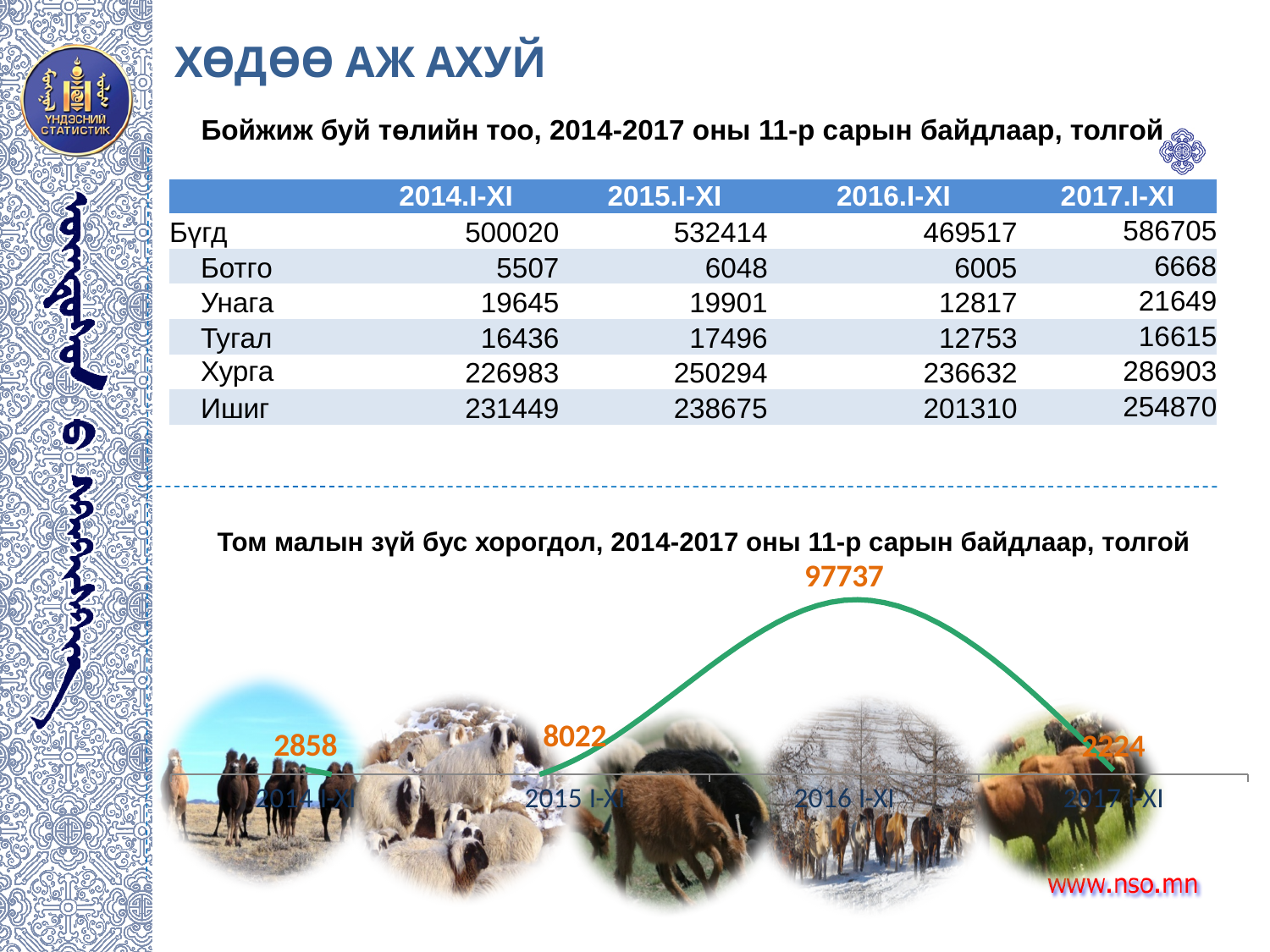
In the chart titled 'Том малын зүй бус хорогдол', what is the value for 2014.I-XI? 2858 In the chart titled 'Том малын зүй бус хорогдол', does the value rise or fall from 2016.I-XI to 2017.I-XI? fall How many data points are plotted in the chart titled 'Том малын зүй бус хорогдол'? 4 In the chart titled 'Том малын зүй бус хорогдол', what is the value for 2015.I-XI? 8022 In the chart titled 'Том малын зүй бус хорогдол, 2014-2017 оны 11-р сарын байдлаар, толгой', what is the value for 2016.I-XI? 97737 In the chart titled 'Том малын зүй бус хорогдол', which is larger, the value for 2015.I-XI or the value for 2014.I-XI? 2015.I-XI In the chart titled 'Том малын зүй бус хорогдол', what is the difference between the values for 2016.I-XI and 2015.I-XI? 89715 In the chart titled 'Том малын зүй бус хорогдол', what is the difference between the values for 2014.I-XI and 2017.I-XI? 634 In the chart titled 'Том малын зүй бус хорогдол', what is the value for 2017.I-XI? 2224 In the chart titled 'Том малын зүй бус хорогдол', which period has the highest value? 2016.I-XI In the chart titled 'Том малын зүй бус хорогдол', which period has the lowest value? 2017.I-XI What kind of chart is the one titled 'Том малын зүй бус хорогдол' at the bottom of the slide? line chart